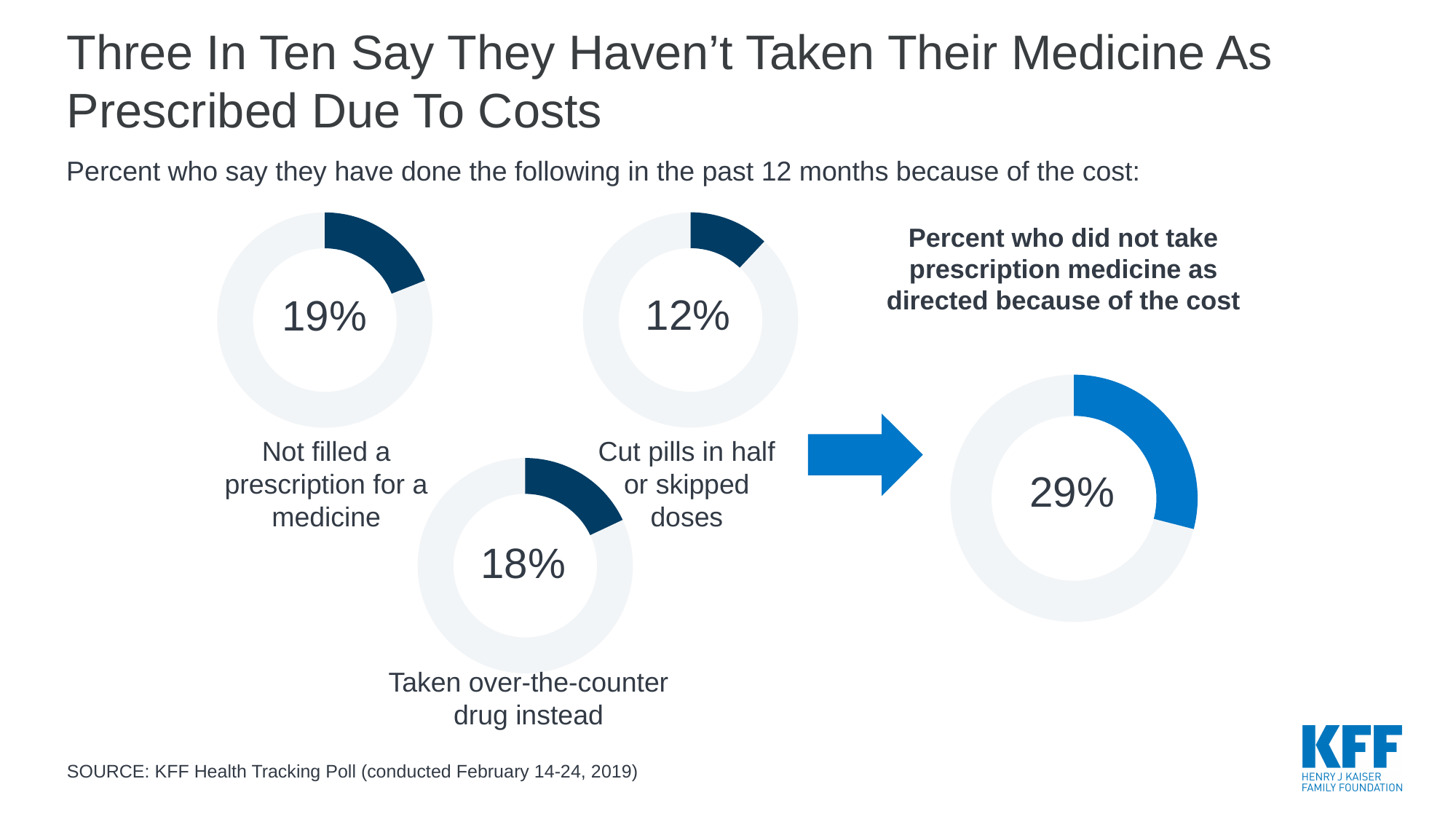
What is the difference in percentage points between those who have not filled a prescription and those who cut pills in half or skipped doses? 7 Which of the three cost-related actions has the lowest percent? Cut pills in half or skipped doses What is the difference in percentage points between the overall 29% and the 18% who took an over-the-counter drug instead? 11 How many donut charts are shown on the slide? 4 What kind of chart is used to show the percentages on the slide? Donut chart What colour is the filled segment of the 29% donut chart? Blue What percent say they have not filled a prescription for a medicine because of the cost? 19% What percent say they have taken an over-the-counter drug instead because of the cost? 18% What percent say they have cut pills in half or skipped doses because of the cost? 12% Which of the three cost-related actions has the highest percent? Not filled a prescription for a medicine Which is larger: the percent who have not filled a prescription or the percent who have taken an over-the-counter drug instead? Not filled a prescription for a medicine What percent did not take prescription medicine as directed because of the cost? 29%